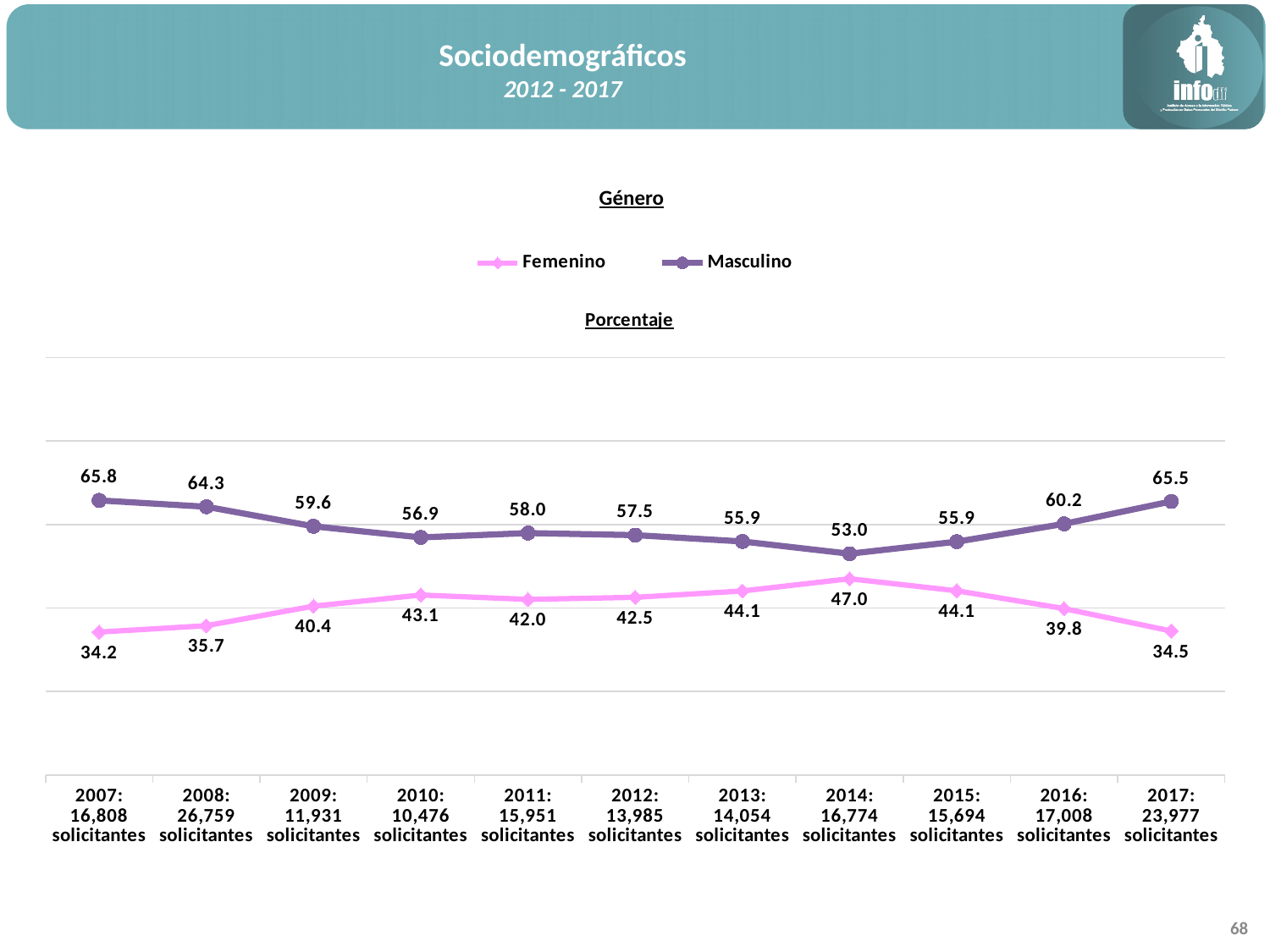
What is the Femenino value for 2017? 34.5 What is the difference between the Masculino and Femenino values in 2007? 31.6 What is the Femenino value for 2014? 47.0 What kind of chart is shown on the slide? Line chart Which is larger in 2016, the Femenino value or the Masculino value? Masculino In which year is the Femenino value highest? 2014 How many series does the legend list? 2 What is the difference between the Masculino and Femenino values in 2014? 6.0 In which year is the Masculino value lowest? 2014 How many years are shown on the x axis? 11 What is the Masculino value for 2010? 56.9 In which year is the Masculino value highest? 2007